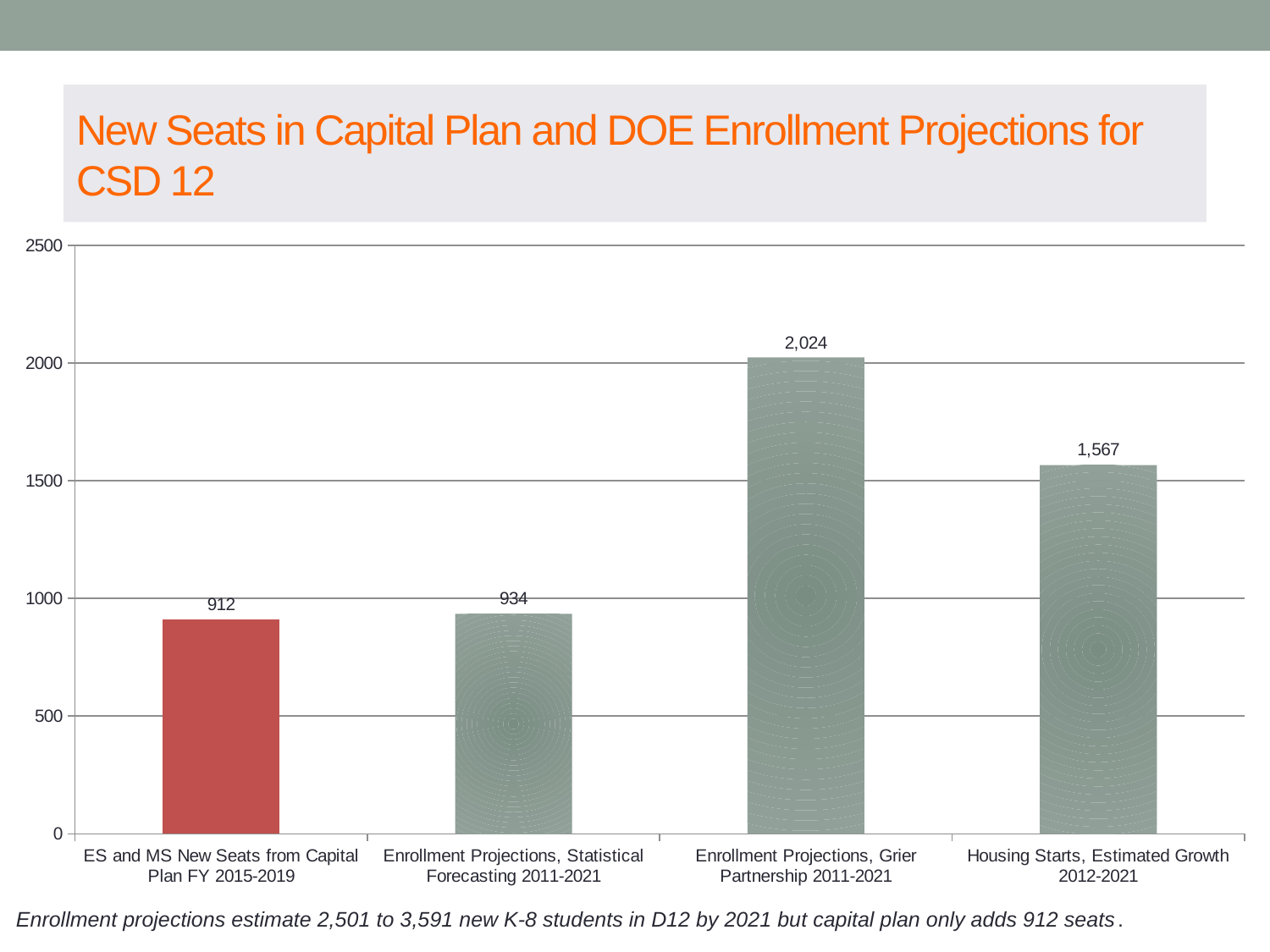
What is the value for ES and MS New Seats from Capital Plan FY 2015-2019? 912 Which category has the lowest value? ES and MS New Seats from Capital Plan FY 2015-2019 Which category has the highest value? Enrollment Projections, Grier Partnership 2011-2021 Which bar is shown in a different colour (red) from the others? ES and MS New Seats from Capital Plan FY 2015-2019 What is the value for Enrollment Projections, Grier Partnership 2011-2021? 2,024 What is the difference between the Grier Partnership enrollment projection and the new seats from the Capital Plan? 1,112 Which is larger: Enrollment Projections, Grier Partnership 2011-2021 or Housing Starts, Estimated Growth 2012-2021? Enrollment Projections, Grier Partnership 2011-2021 What is the difference between the Housing Starts, Estimated Growth 2012-2021 value and the Enrollment Projections, Statistical Forecasting 2011-2021 value? 633 What kind of chart is shown on the slide? Bar chart What is the value for Housing Starts, Estimated Growth 2012-2021? 1,567 How many categories are shown in the chart? 4 What is the value for Enrollment Projections, Statistical Forecasting 2011-2021? 934